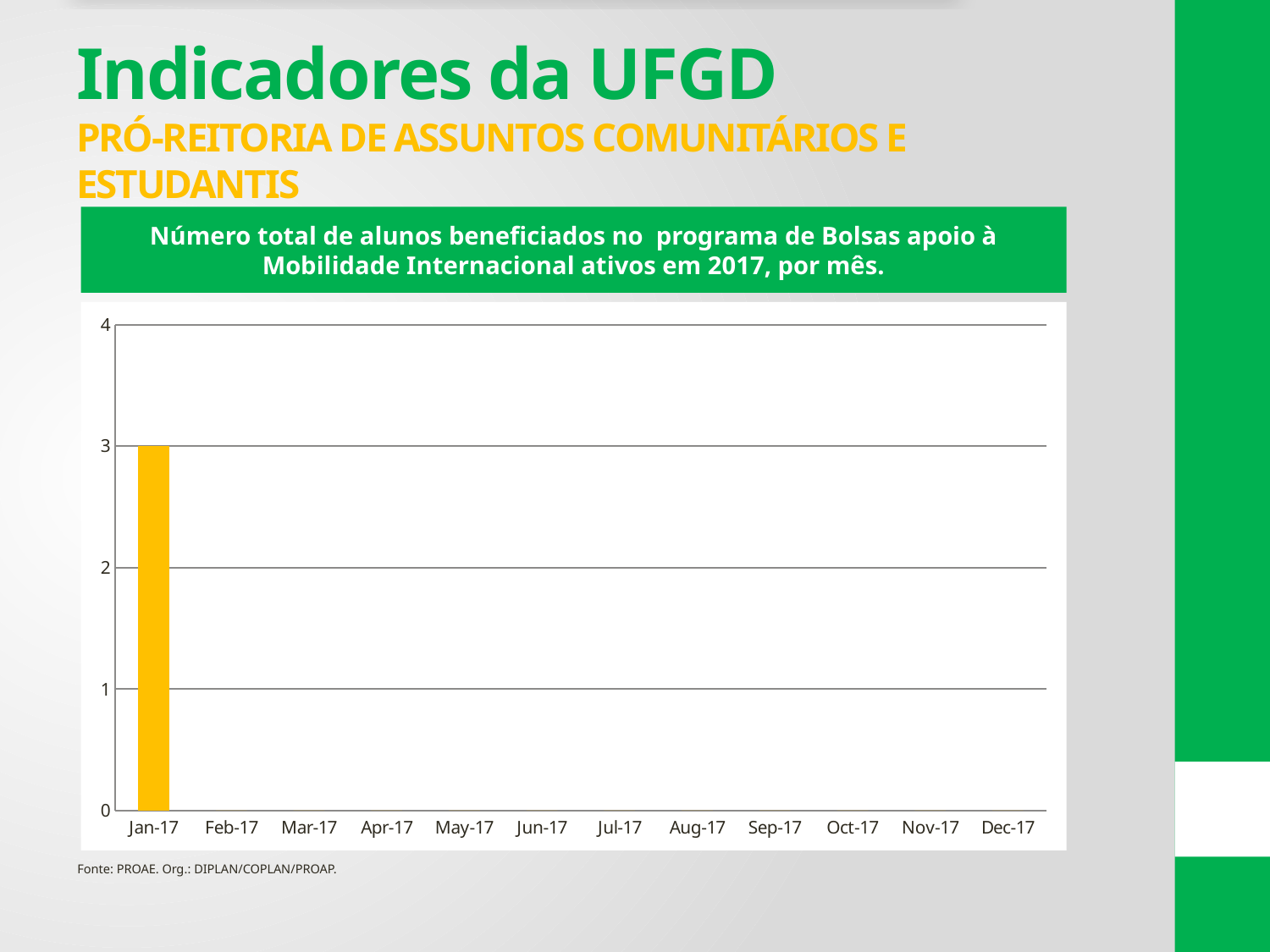
What is the value for Jan-17 in the chart? 3 Do the values rise or fall from Jan-17 to Feb-17? fall Which is larger, the value for Jan-17 or the value for Feb-17? Jan-17 What kind of chart is shown on the slide? bar chart Is the value for Jan-17 greater or less than 2? greater What is the title of the chart? Número total de alunos beneficiados no programa de Bolsas apoio à Mobilidade Internacional ativos em 2017, por mês. What colour is the bar in the chart? yellow How many months are shown on the x axis of the chart? 12 Which month has the highest value in the chart? Jan-17 Is the value for Jan-17 greater or less than 4? less Which is the only month with a visible bar in the chart? Jan-17